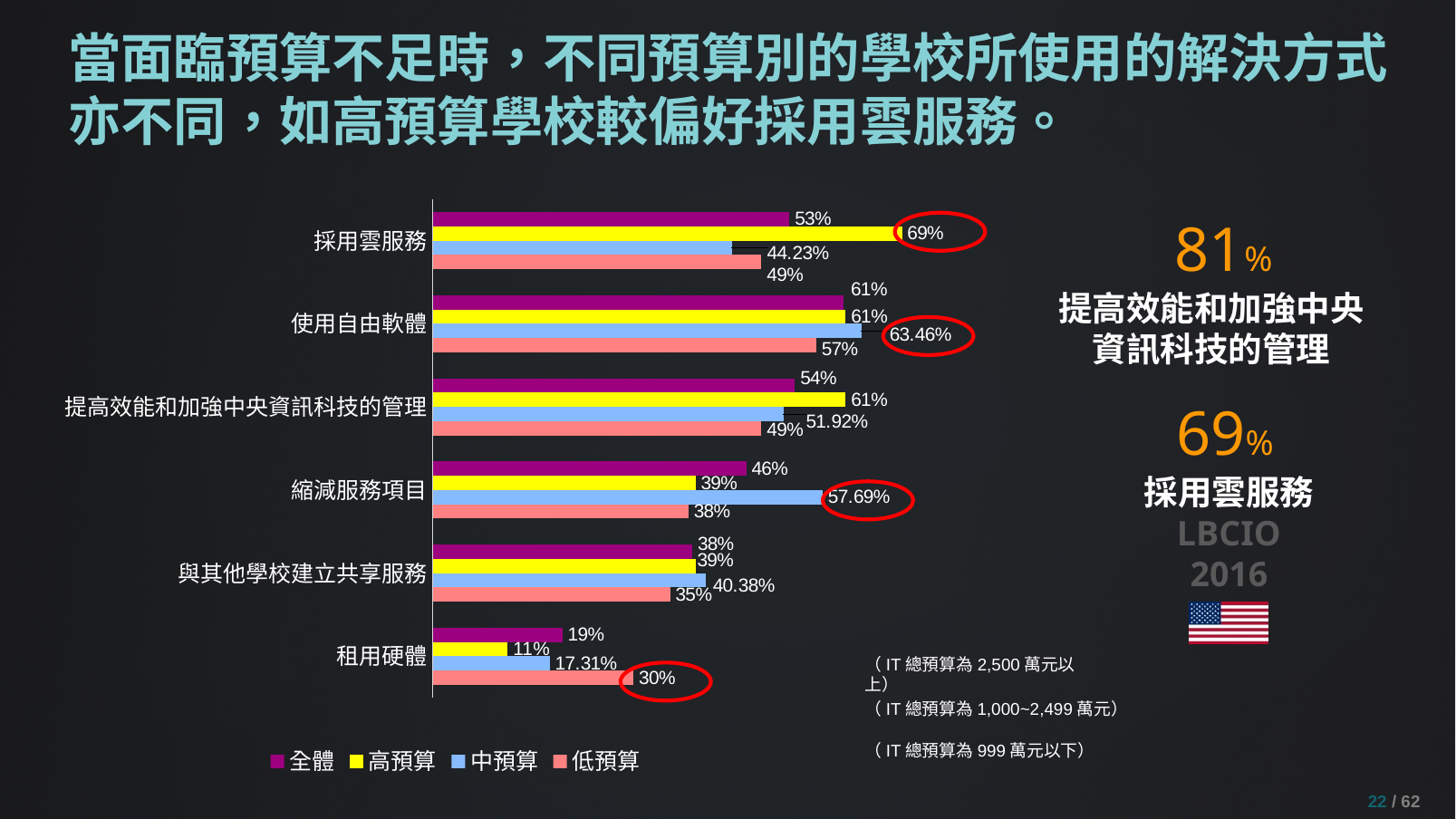
What is the value for 中預算 in the 縮減服務項目 category? 57.69% How many categories are shown on the bar chart? 6 In the 租用硬體 category, which is larger: the 全體 value or the 低預算 value? 低預算 Which category has the lowest value for the 高預算 series? 租用硬體 What is the value for 高預算 in the 採用雲服務 category? 69% What is the difference between the 高預算 and 中預算 values in the 採用雲服務 category? 24.77% Which colour represents the 高預算 series in the chart? yellow What is the value for 低預算 in the 租用硬體 category? 30% What is the value for 全體 in the 提高效能和加強中央資訊科技的管理 category? 54% Which category has the highest value for the 中預算 series? 使用自由軟體 What type of chart is shown on the slide? bar chart How many series does the legend list? 4